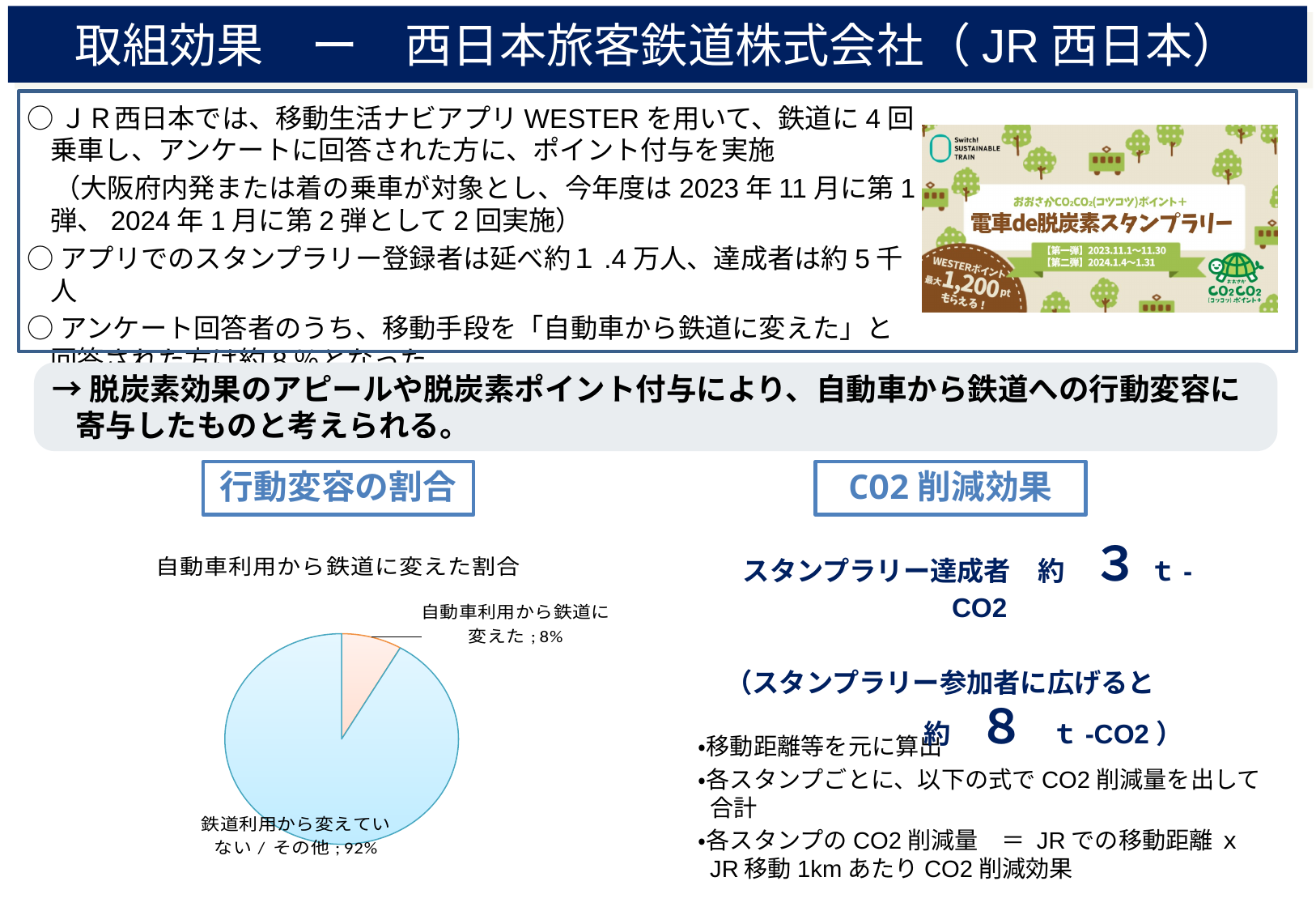
Which slice of the pie chart is the largest? 鉄道利用から変えていない / その他 What kind of chart is shown under 行動変容の割合? pie chart What colour is the 自動車利用から鉄道に変えた slice in the pie chart? light orange Which slice of the pie chart is the smallest? 自動車利用から鉄道に変えた What share of the pie is labelled 鉄道利用から変えていない / その他? 92% What is the title of the pie chart? 自動車利用から鉄道に変えた割合 Which is larger in the pie chart: 自動車利用から鉄道に変えた or 鉄道利用から変えていない / その他? 鉄道利用から変えていない / その他 How many slices does the pie chart have? 2 What is the total of the two slices shown in the pie chart? 100% What is the difference in percentage points between the 鉄道利用から変えていない / その他 slice and the 自動車利用から鉄道に変えた slice? 84 What share of the pie is labelled 自動車利用から鉄道に変えた? 8%